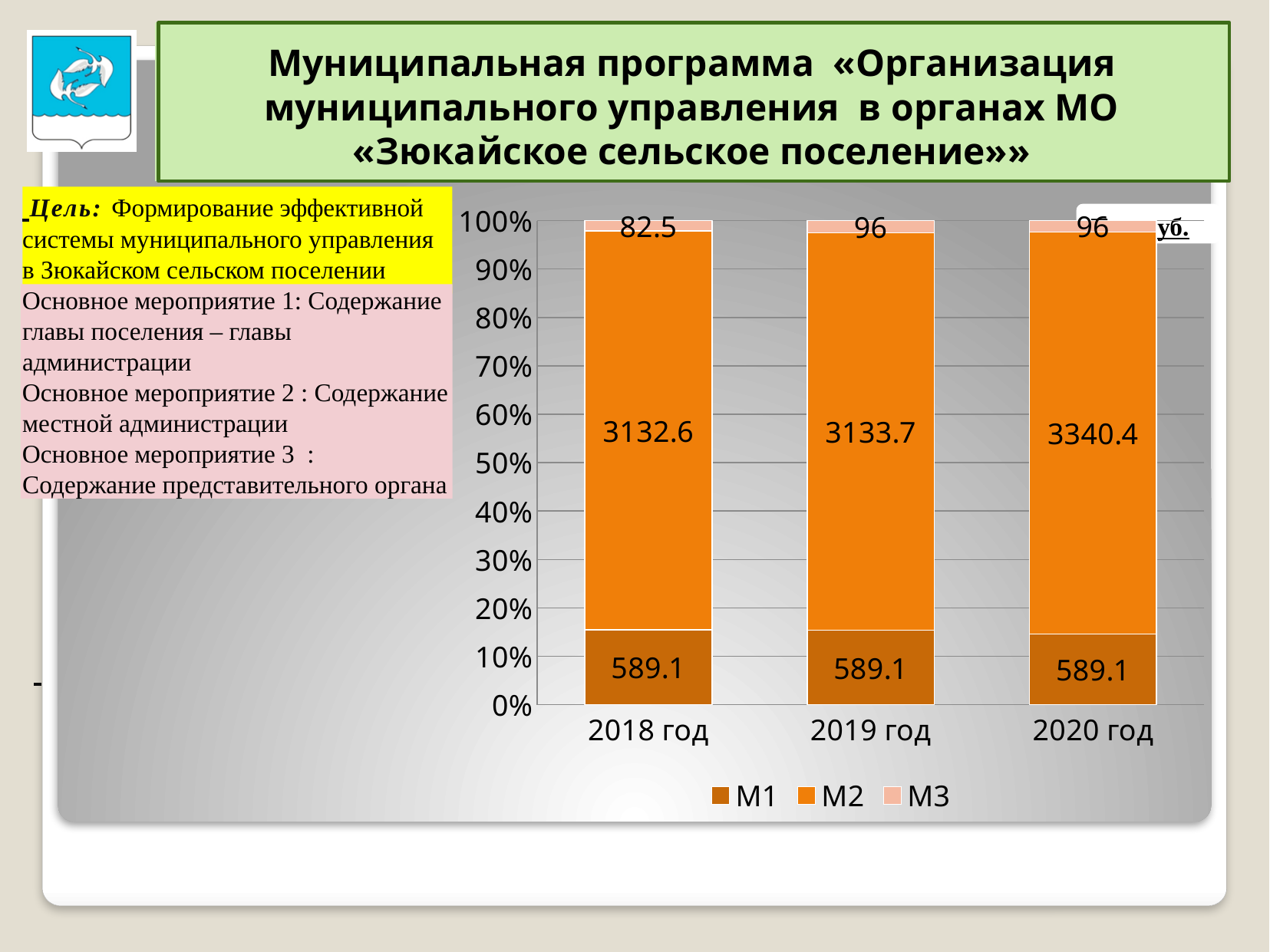
What is the total of the stacked bar for 2018 год? 3804.2 What kind of chart is shown on the slide? Stacked bar chart What is the value of М3 for 2018 год? 82.5 In which year is the М3 value lowest? 2018 год What is the value of М2 for 2020 год? 3340.4 What is the value of М1 for 2019 год? 589.1 How many years are shown on the x axis? 3 What is the difference between the М2 values for 2020 год and 2018 год? 207.8 Which is larger: the М2 value for 2019 год or for 2018 год? 2019 год What is the difference between the М3 values for 2019 год and 2018 год? 13.5 In which year is the М2 value highest? 2020 год How many series does the legend list? 3